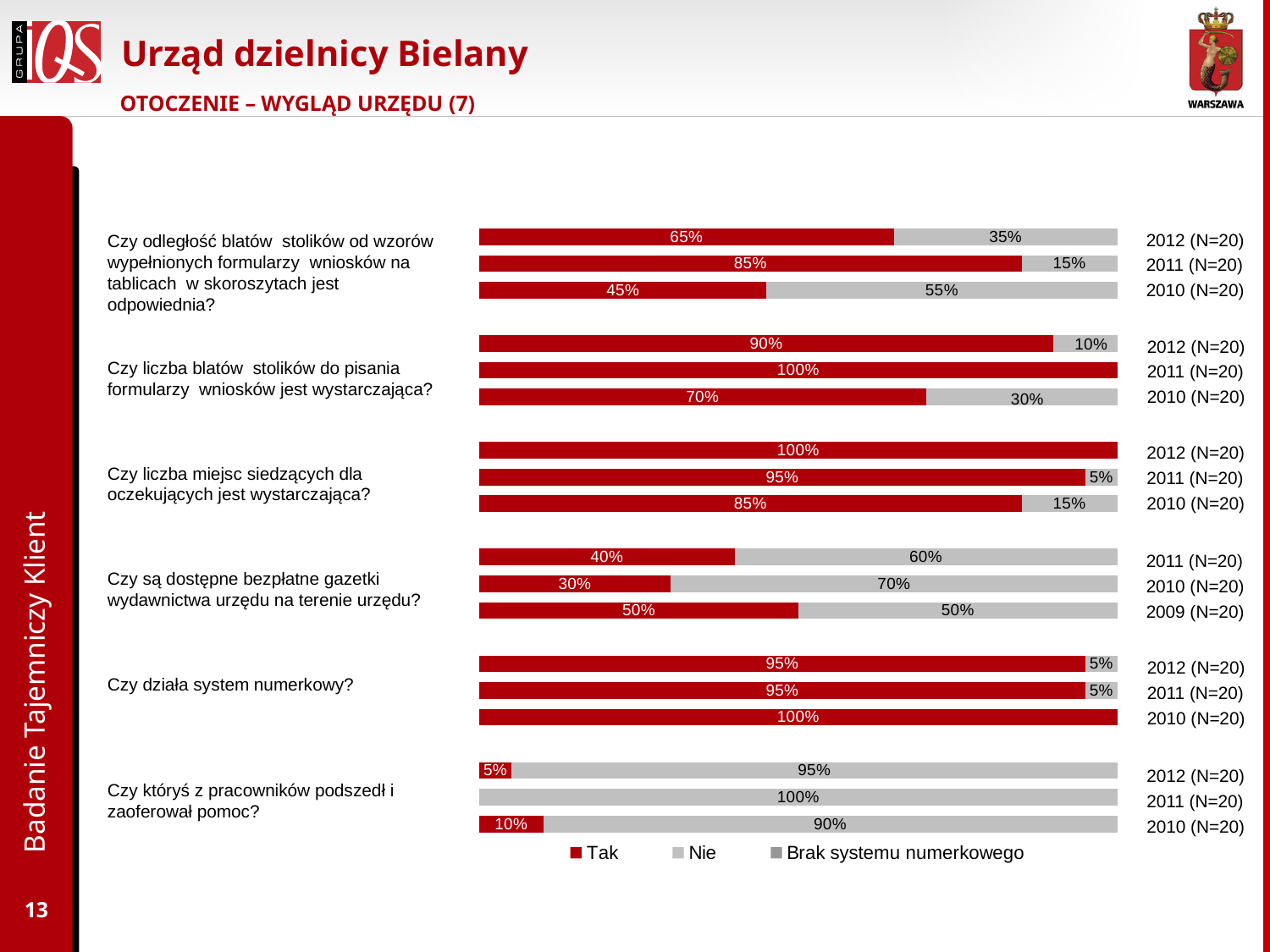
For the question "Czy są dostępne bezpłatne gazetki wydawnictwa urzędu na terenie urzędu?", which year had the lowest "Tak" share? 2010 What is the sample size (N) shown for each bar in the chart? N=20 For the question "Czy liczba blatów stolików do pisania formularzy wniosków jest wystarczająca?", which year had the highest "Tak" share? 2011 What kind of chart is shown on the slide? Stacked horizontal bar chart What percentage answered "Tak" in 2010 to the question "Czy któryś z pracowników podszedł i zaoferował pomoc?" 10% What percentage answered "Tak" in 2010 to the question "Czy liczba miejsc siedzących dla oczekujących jest wystarczająca?" 85% How many series does the chart legend list? 3 For the question "Czy są dostępne bezpłatne gazetki wydawnictwa urzędu na terenie urzędu?", is the "Tak" share larger in 2011 or in 2009? 2009 What percentage answered "Tak" in 2010 to the question "Czy działa system numerkowy?" 100% What percentage answered "Tak" in 2012 to the question "Czy odległość blatów stolików od wzorów wypełnionych formularzy wniosków na tablicach w skoroszytach jest odpowiednia?" 65% For the question "Czy liczba blatów stolików do pisania formularzy wniosków jest wystarczająca?", what is the difference between the "Tak" share in 2012 and in 2010? 20 percentage points What percentage answered "Nie" in 2010 to the question "Czy odległość blatów stolików od wzorów wypełnionych formularzy wniosków na tablicach w skoroszytach jest odpowiednia?" 55%